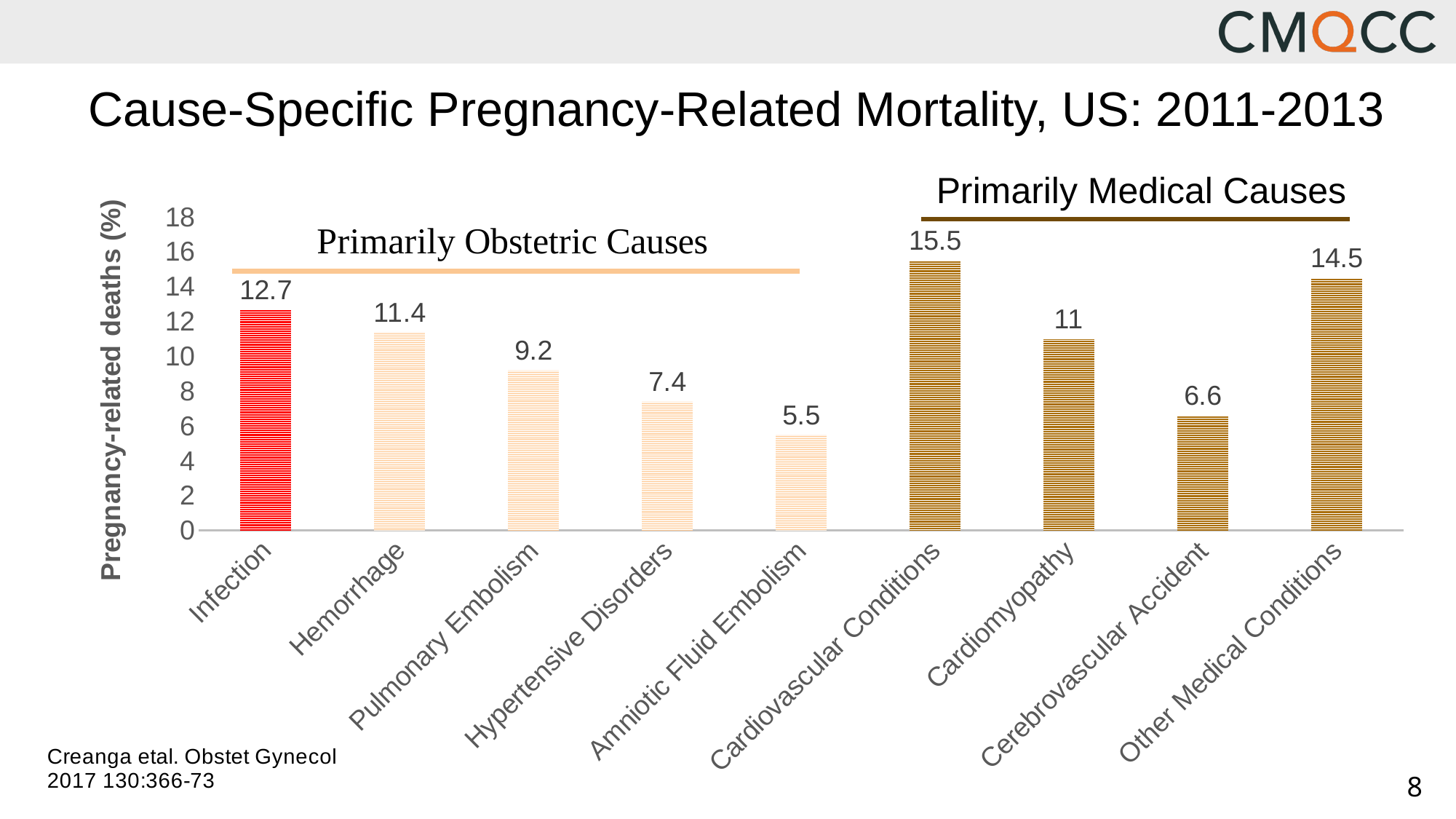
Which bar is shown in red? Infection Which cause has the lowest percentage of pregnancy-related deaths? Amniotic Fluid Embolism What is the difference between the values for Cardiovascular Conditions and Other Medical Conditions? 1 What is the value for Amniotic Fluid Embolism? 5.5 How many causes are shown on the x axis? 9 What is the value for Cardiomyopathy? 11 Which is larger, the value for Pulmonary Embolism or the value for Cerebrovascular Accident? Pulmonary Embolism Which cause has the highest percentage of pregnancy-related deaths? Cardiovascular Conditions Is the value for Other Medical Conditions greater or less than 14? greater What kind of chart is shown on the slide? Bar chart What is the difference between the values for Hemorrhage and Hypertensive Disorders? 4 What is the value for Infection? 12.7